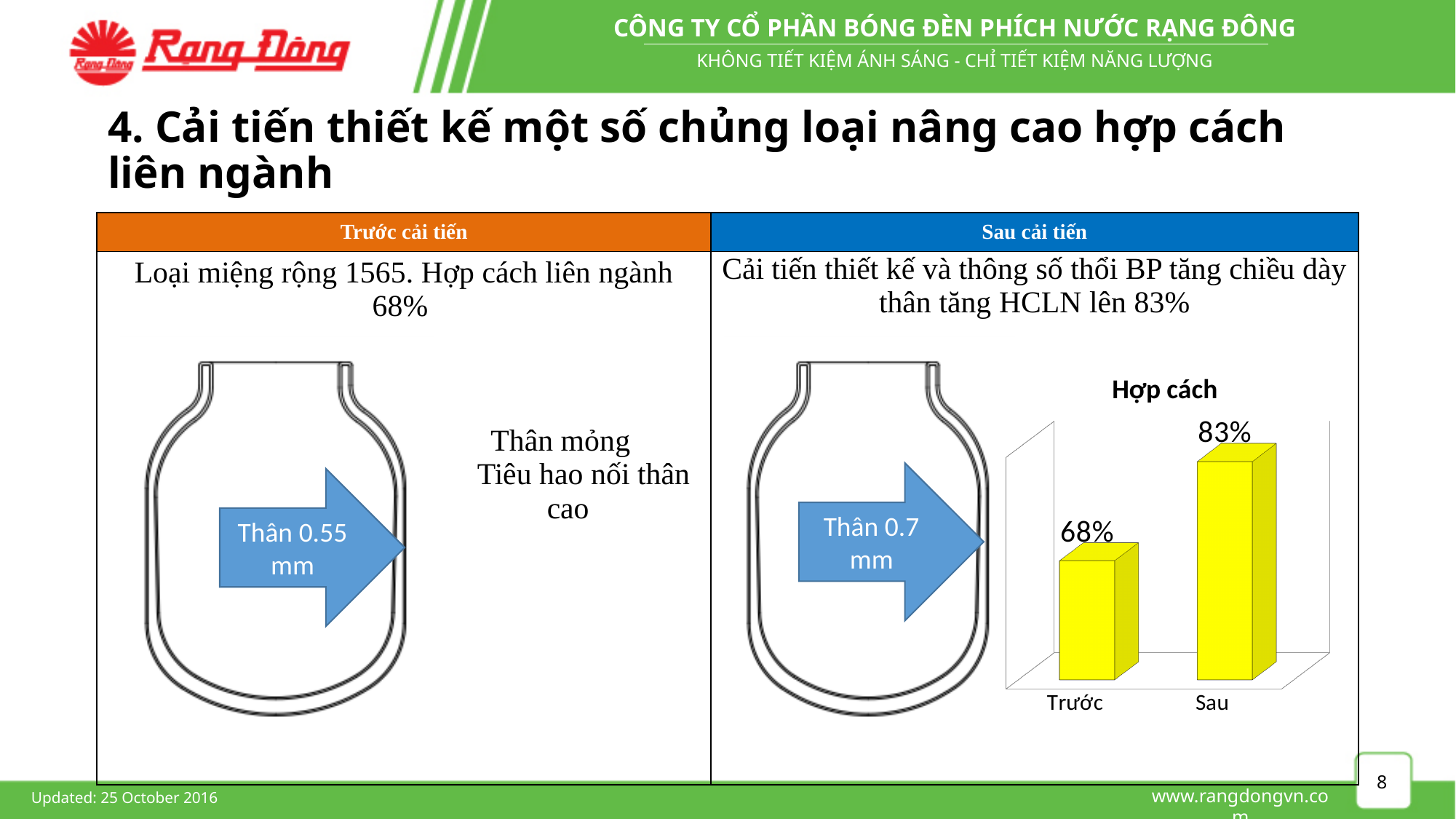
Do the values in the Hợp cách chart rise or fall from Trước to Sau? rise What is the title of the chart on the slide? Hợp cách What is the value for Sau in the Hợp cách chart? 83% In the Hợp cách chart, is the value for Sau larger or smaller than the value for Trước? larger What is the value for Trước in the Hợp cách chart? 68% What kind of chart is the Hợp cách chart? bar chart What is the difference between the Sau and Trước values in the Hợp cách chart? 15% What colour are the bars in the Hợp cách chart? yellow How many categories are shown in the Hợp cách chart? 2 Which category has the lowest value in the Hợp cách chart? Trước Which category has the highest value in the Hợp cách chart? Sau